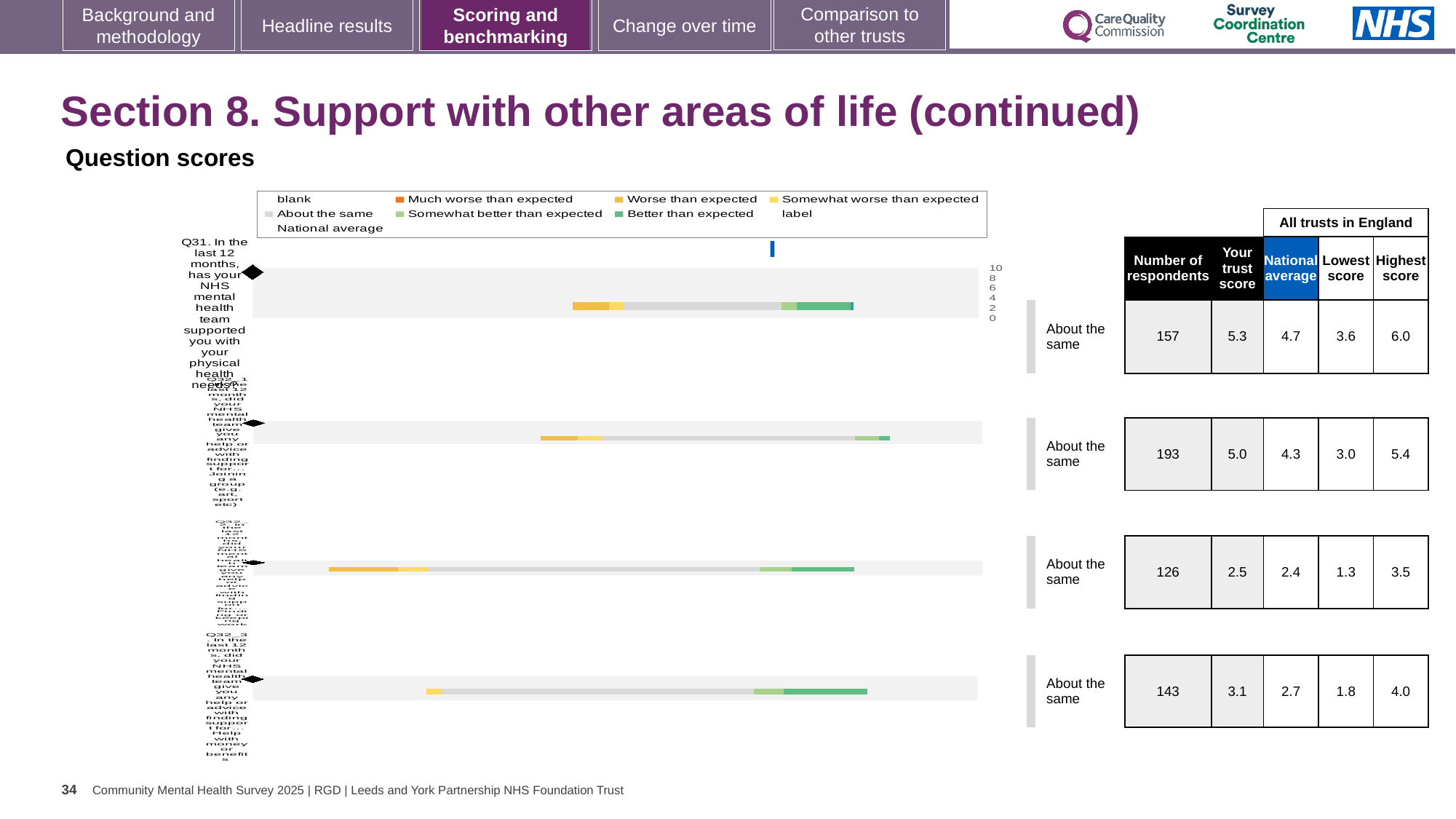
How many question bars are plotted in the chart? 4 What is the benchmark category shown beside every bar in the chart? About the same In the table beside the chart, what is the national average for the second row (Q32_1)? 4.3 In the table beside the chart, what is the difference between the trust score and the national average for the first row (Q31)? 0.6 In the table beside the chart, what is the lowest score for the fourth row (Q32_3)? 1.8 In the table beside the chart, what is the highest score for the third row (Q32_2)? 3.5 In the table beside the chart, what is the trust score for the first row (Q31)? 5.3 In the table beside the chart, what is the number of respondents for the first row (Q31)? 157 In the table beside the chart, which row has the highest number of respondents? Q32_1 (193) How many entries does the chart legend list? 9 What kind of chart is shown on the slide? bar chart Which legend entry is shown in orange? Much worse than expected